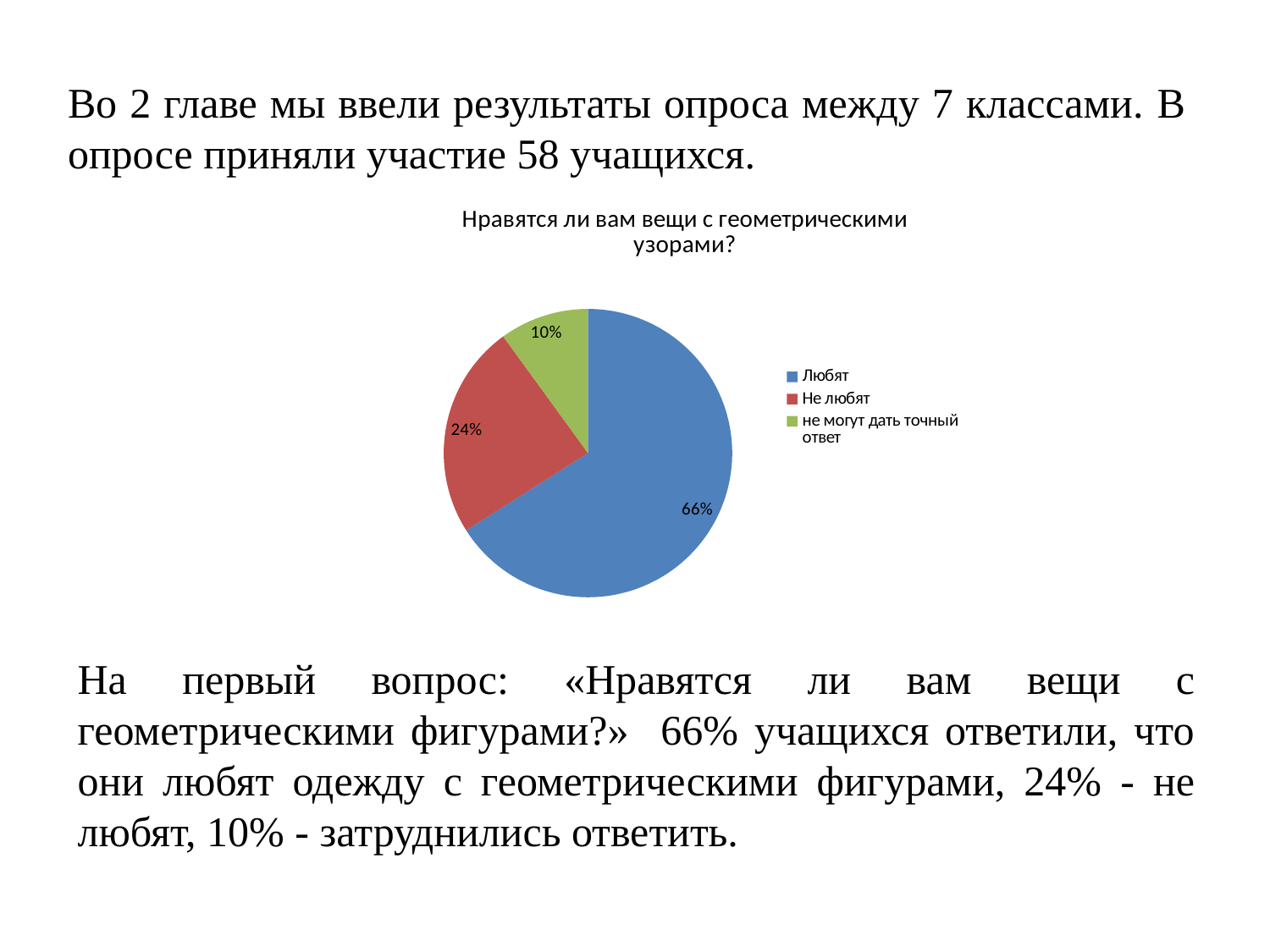
Which category has the smallest slice of the pie? не могут дать точный ответ What kind of chart is shown on the slide? pie chart What is the title of the chart? Нравятся ли вам вещи с геометрическими узорами? Which category has the largest slice of the pie? Любят What share of the pie does the "Любят" slice represent? 66% What colour is the "Любят" slice? blue What is the difference in percentage points between the "Не любят" and "не могут дать точный ответ" slices? 14 What is the difference in percentage points between the "Любят" and "Не любят" slices? 42 What share of the pie does the "не могут дать точный ответ" slice represent? 10% Which slice is larger, "Не любят" or "не могут дать точный ответ"? Не любят What share of the pie does the "Не любят" slice represent? 24% How many slices does the pie chart have? 3